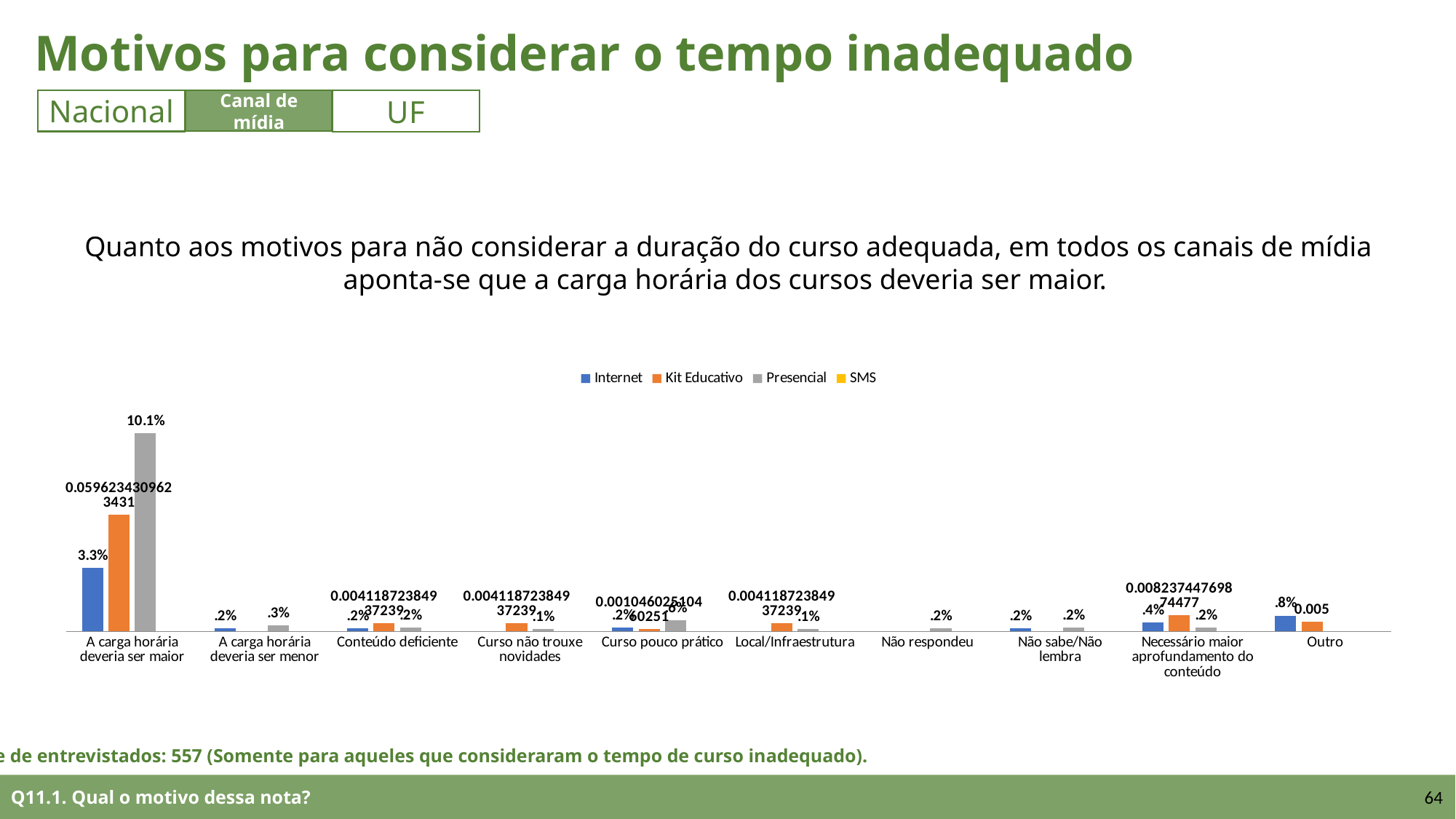
How many series does the legend list? 4 What kind of chart is shown on the slide? bar chart What is the value for Presencial in the category 'Curso pouco prático'? .6% In the category 'A carga horária deveria ser maior', which is larger: the Internet value or the Presencial value? Presencial What is the value for Internet in the category 'Outro'? .8% How many categories are shown along the x axis? 10 What is the difference between the Presencial value and the Internet value in the category 'A carga horária deveria ser maior'? 6.8% What is the value for Internet in the category 'A carga horária deveria ser maior'? 3.3% Which series is shown in orange in the legend? Kit Educativo Which category has the highest value for the Presencial series? A carga horária deveria ser maior What is the value for Presencial in the category 'A carga horária deveria ser maior'? 10.1% What is the value for Internet in the category 'Necessário maior aprofundamento do conteúdo'? .4%